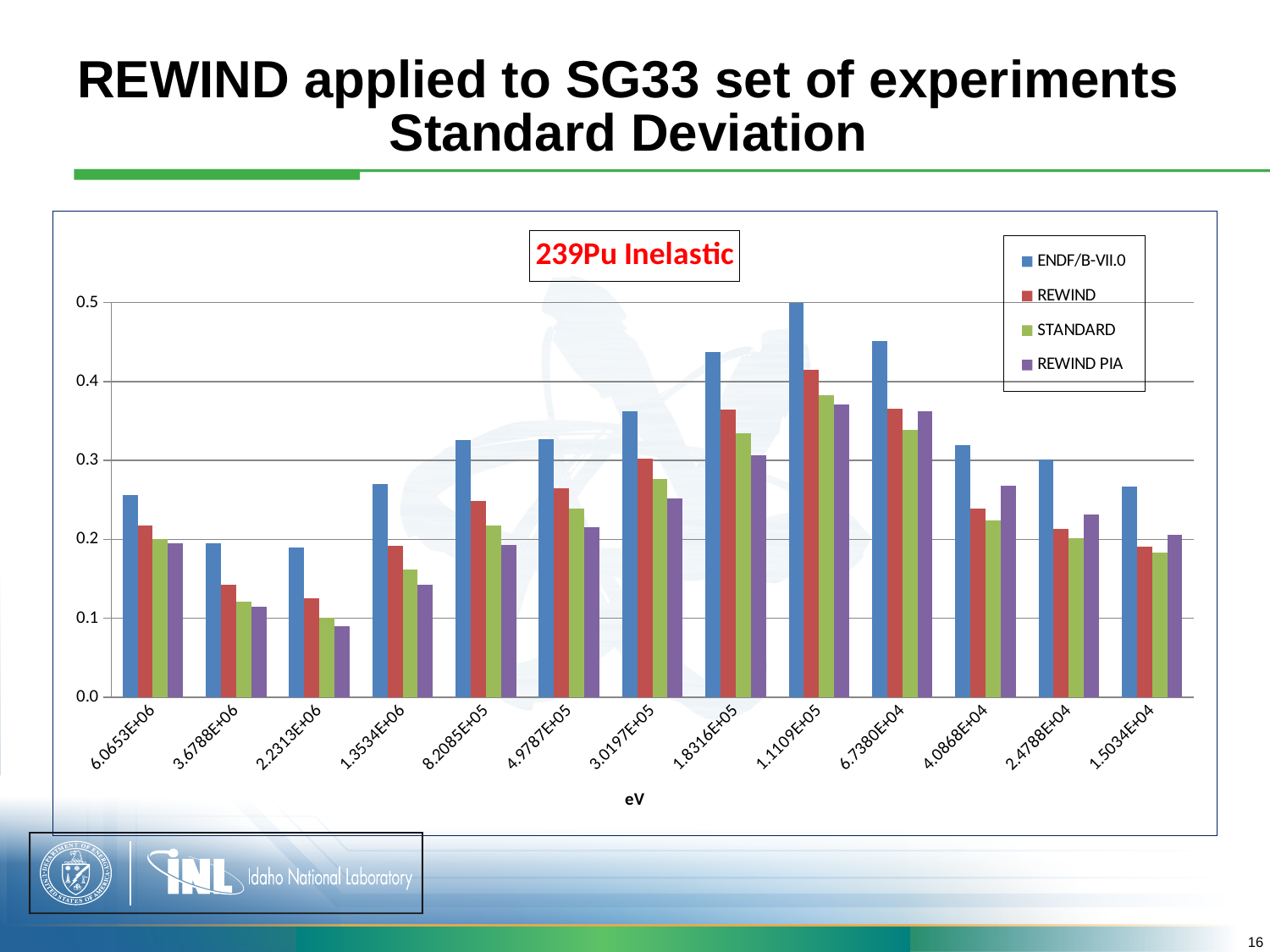
What is the label of the x axis? eV What is the title shown inside the chart? 239Pu Inelastic Is the REWIND value for 2.2313E+06 greater or less than 0.2? less At 4.0868E+04, which is larger: the STANDARD value or the REWIND PIA value? REWIND PIA Is the STANDARD value for 1.1109E+05 greater or less than 0.3? greater How many series does the legend list? 4 Is the ENDF/B-VII.0 value for 1.1109E+05 greater or less than 0.4? greater What kind of chart is shown on the slide? bar chart For which energy category is the ENDF/B-VII.0 value highest? 1.1109E+05 How many energy categories are shown along the x axis? 13 At 1.1109E+05, which is larger: the ENDF/B-VII.0 value or the REWIND value? ENDF/B-VII.0